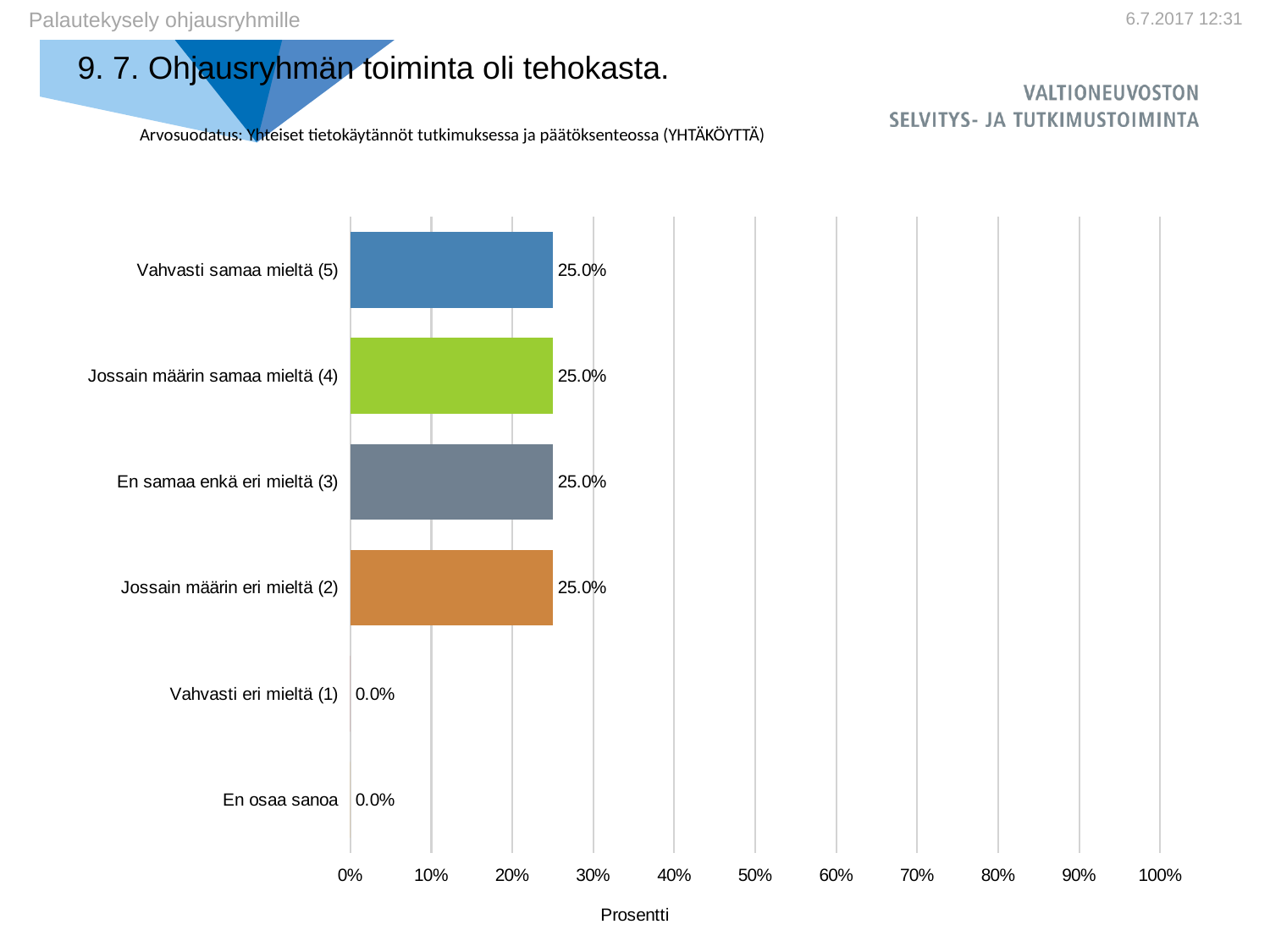
What is the value for "Jossain määrin samaa mieltä (4)"? 25.0% What is the difference between the value for "Jossain määrin eri mieltä (2)" and the value for "En osaa sanoa"? 25.0% What is the value for "En osaa sanoa"? 0.0% What is the value for "Vahvasti samaa mieltä (5)"? 25.0% How many categories are shown on the chart? 6 What is the value for "Jossain määrin eri mieltä (2)"? 25.0% Is the value for "En samaa enkä eri mieltä (3)" greater or less than 30%? less What is the value for "En samaa enkä eri mieltä (3)"? 25.0% What is the value for "Vahvasti eri mieltä (1)"? 0.0% What is the label of the horizontal axis? Prosentti Which is larger, the value for "Vahvasti samaa mieltä (5)" or the value for "Vahvasti eri mieltä (1)"? Vahvasti samaa mieltä (5) What kind of chart is shown on the slide? bar chart